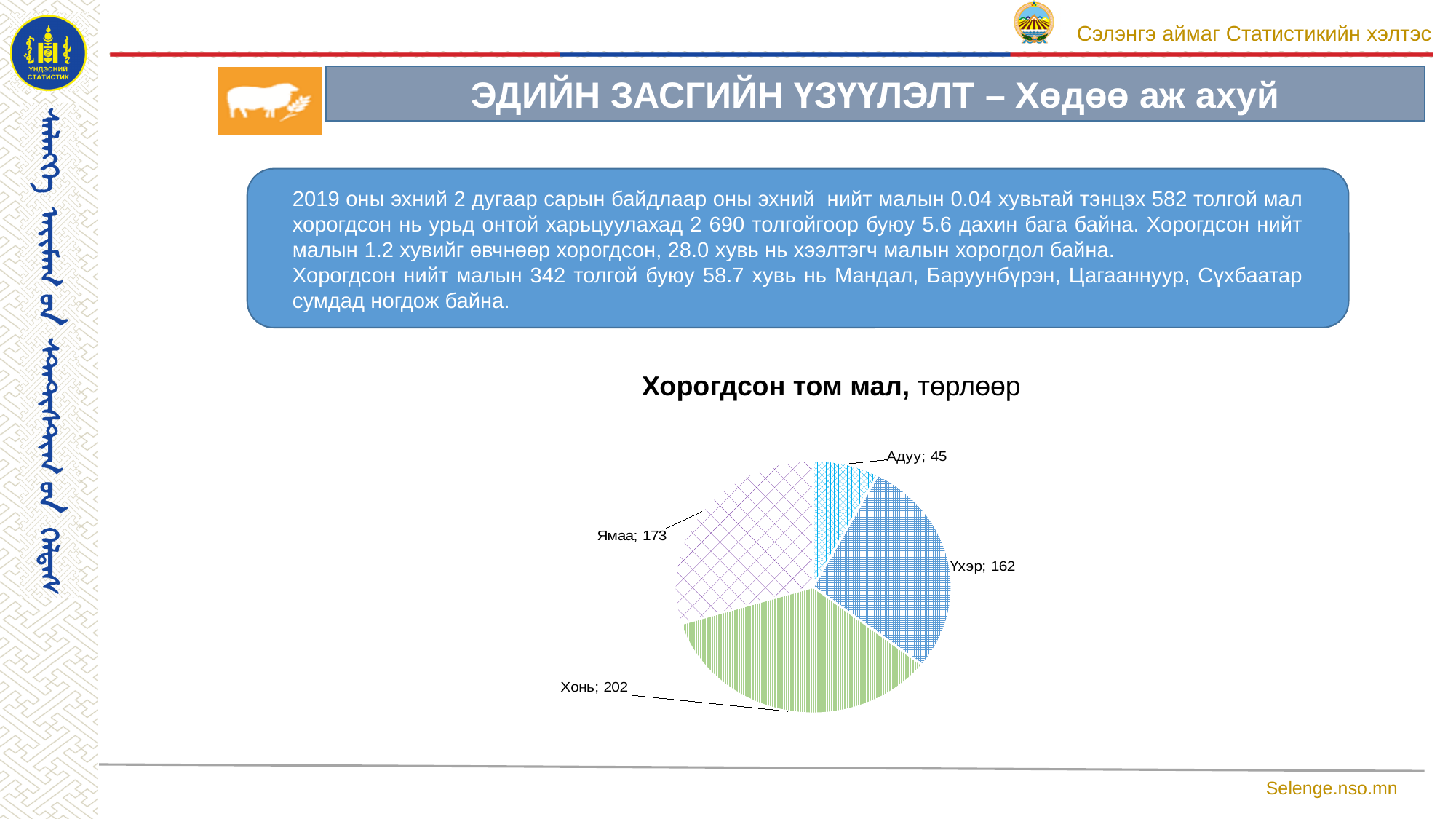
What is the value for Ямаа in the pie chart? 173 What is the difference between the values for Үхэр and Адуу? 117 How many categories are shown in the pie chart? 4 Which category has the smallest slice in the pie chart? Адуу What type of chart is shown on the slide? pie chart Which category has the largest slice in the pie chart? Хонь What is the value for Хонь in the pie chart? 202 What is the value for Үхэр in the pie chart? 162 What is the value for Адуу in the pie chart? 45 What is the difference between the values for Хонь and Ямаа? 29 What is the title of the pie chart? Хорогдсон том мал, төрлөөр Which is larger, the value for Ямаа or the value for Үхэр? Ямаа